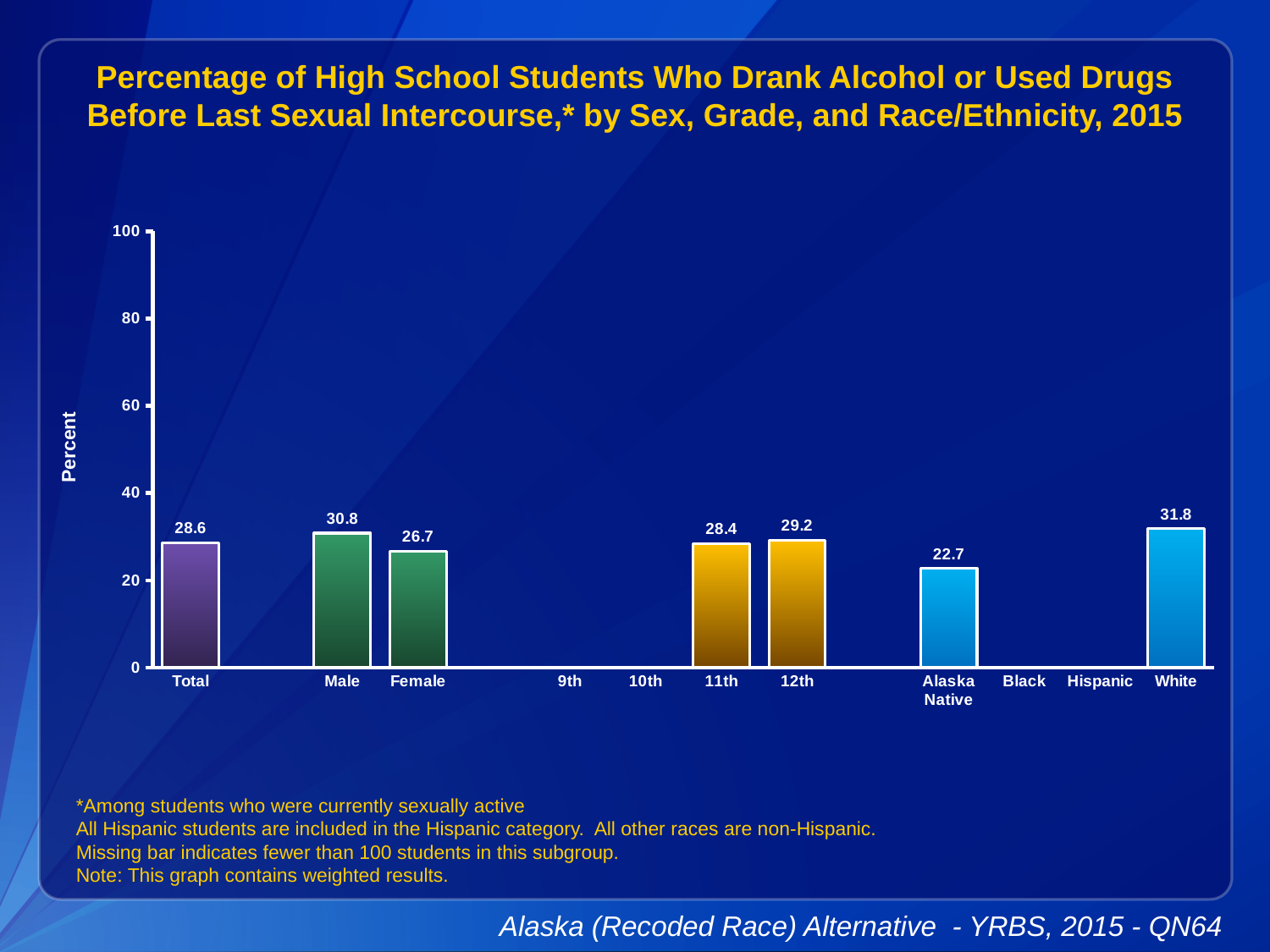
What is the value for 12th grade? 29.2 What is the value for Total? 28.6 What is the value for Male? 30.8 How many bars are plotted on the chart? 7 Is the value for White greater or less than 40? less Which is larger, the value for 11th grade or 12th grade? 12th What is the value for Alaska Native? 22.7 Which category with a plotted bar has the lowest value? Alaska Native What kind of chart is shown? bar chart What is the difference between the Male and Female values? 4.1 What is the label of the y axis? Percent Which category has the highest value? White